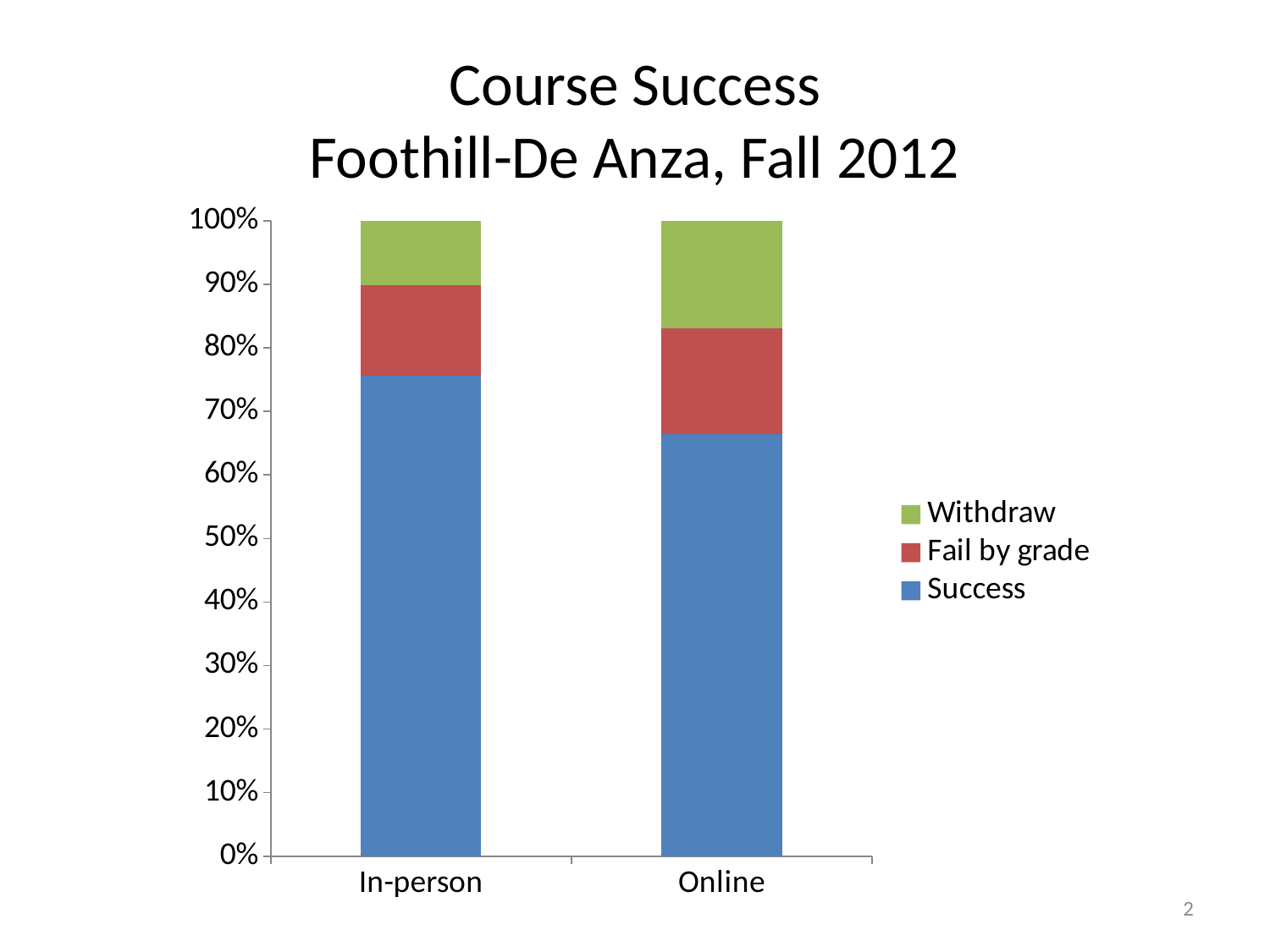
Is the Success share for In-person greater or less than 70%? greater Is the Success share for Online greater or less than 70%? less What kind of chart is shown on the slide? Stacked bar chart Which colour represents the Success series in the legend? Blue Which category has the larger Success share, In-person or Online? In-person What is the total height of the In-person stacked bar? 100% What is the total height of the Online stacked bar? 100% What is the title of the chart? Course Success Foothill-De Anza, Fall 2012 Which category has the larger Withdraw share, In-person or Online? Online How many series does the legend list? 3 Is the Withdraw share for In-person greater or less than 20%? less How many categories are shown on the x axis? 2